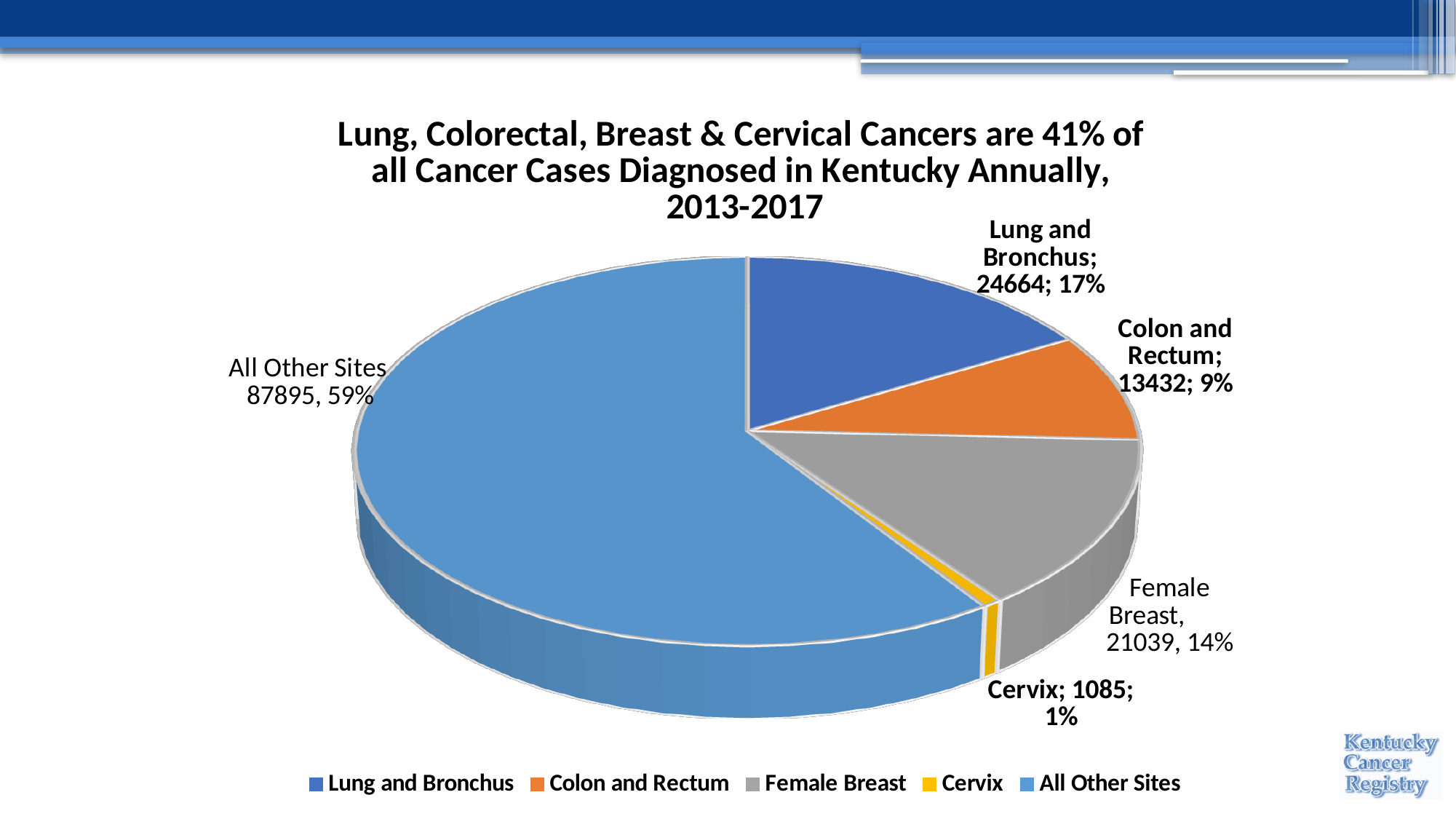
What is the difference in cases between Lung and Bronchus and Colon and Rectum? 11232 What percentage of cases does Cervix represent? 1% What percentage of cases does Colon and Rectum represent? 9% What type of chart is shown on the slide? Pie chart How many cases are shown for All Other Sites? 87895 How many categories does the legend list? 5 How many cases are shown for Lung and Bronchus? 24664 Which category has the largest slice of the pie? All Other Sites Which category has the smallest slice of the pie? Cervix How many cases are shown for Female Breast? 21039 Which has more cases, Female Breast or Colon and Rectum? Female Breast What is the title of the chart? Lung, Colorectal, Breast & Cervical Cancers are 41% of all Cancer Cases Diagnosed in Kentucky Annually, 2013-2017